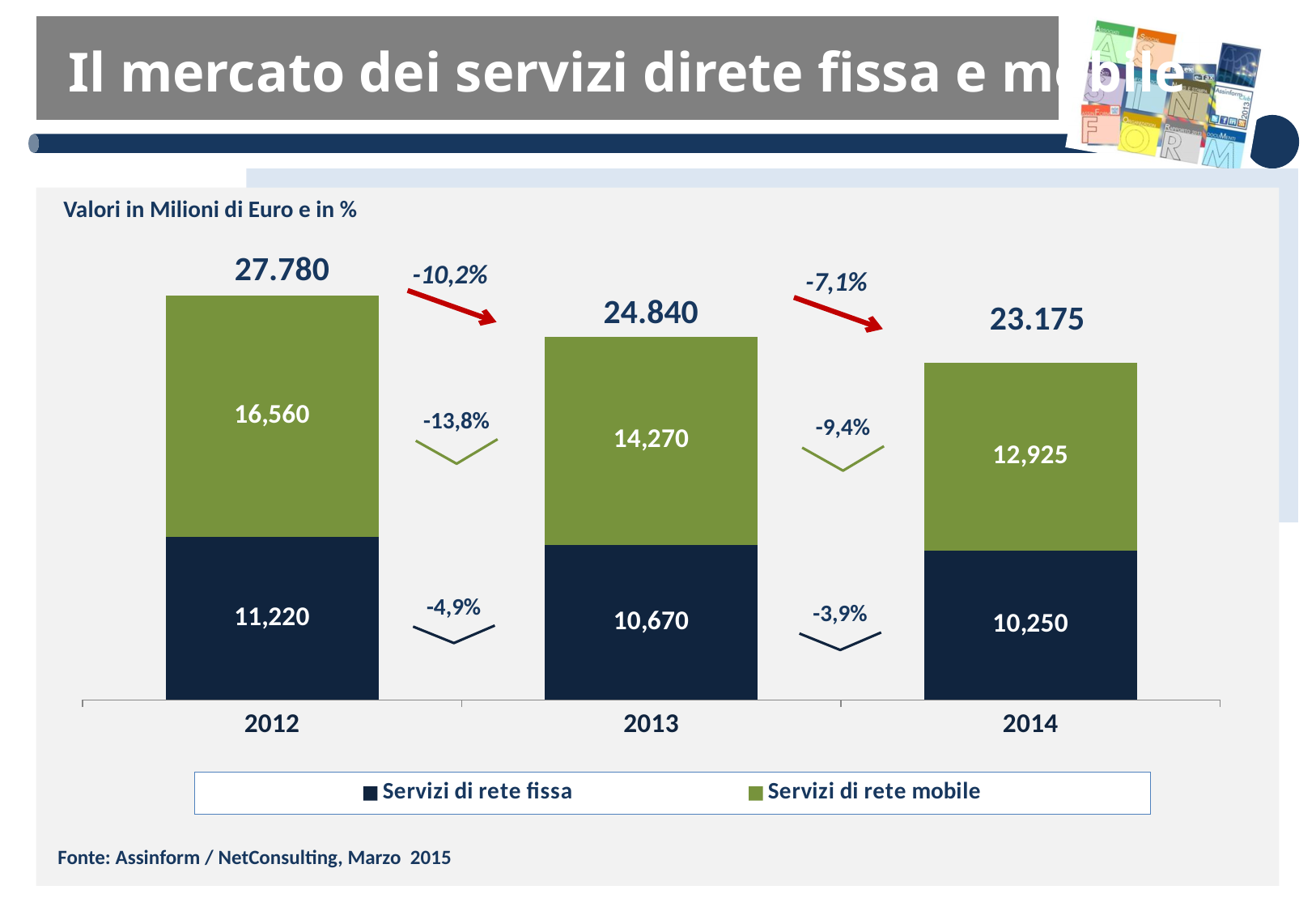
Which year has the lowest value for Servizi di rete fissa? 2014 How many series does the legend list? 2 Which year has the highest total value? 2012 Do the total values rise or fall from 2012 to 2014? fall What is the value for Servizi di rete fissa in 2014? 10,250 Which is larger in 2014, Servizi di rete fissa or Servizi di rete mobile? Servizi di rete mobile What is the total value shown above the bar for 2013? 24.840 What percentage change is shown for Servizi di rete mobile between 2013 and 2014? -9,4% What percentage change is shown for the total market between 2012 and 2013? -10,2% How many years are shown on the x axis? 3 What is the value for Servizi di rete mobile in 2012? 16,560 What is the difference between the Servizi di rete mobile values for 2012 and 2013? 2,290